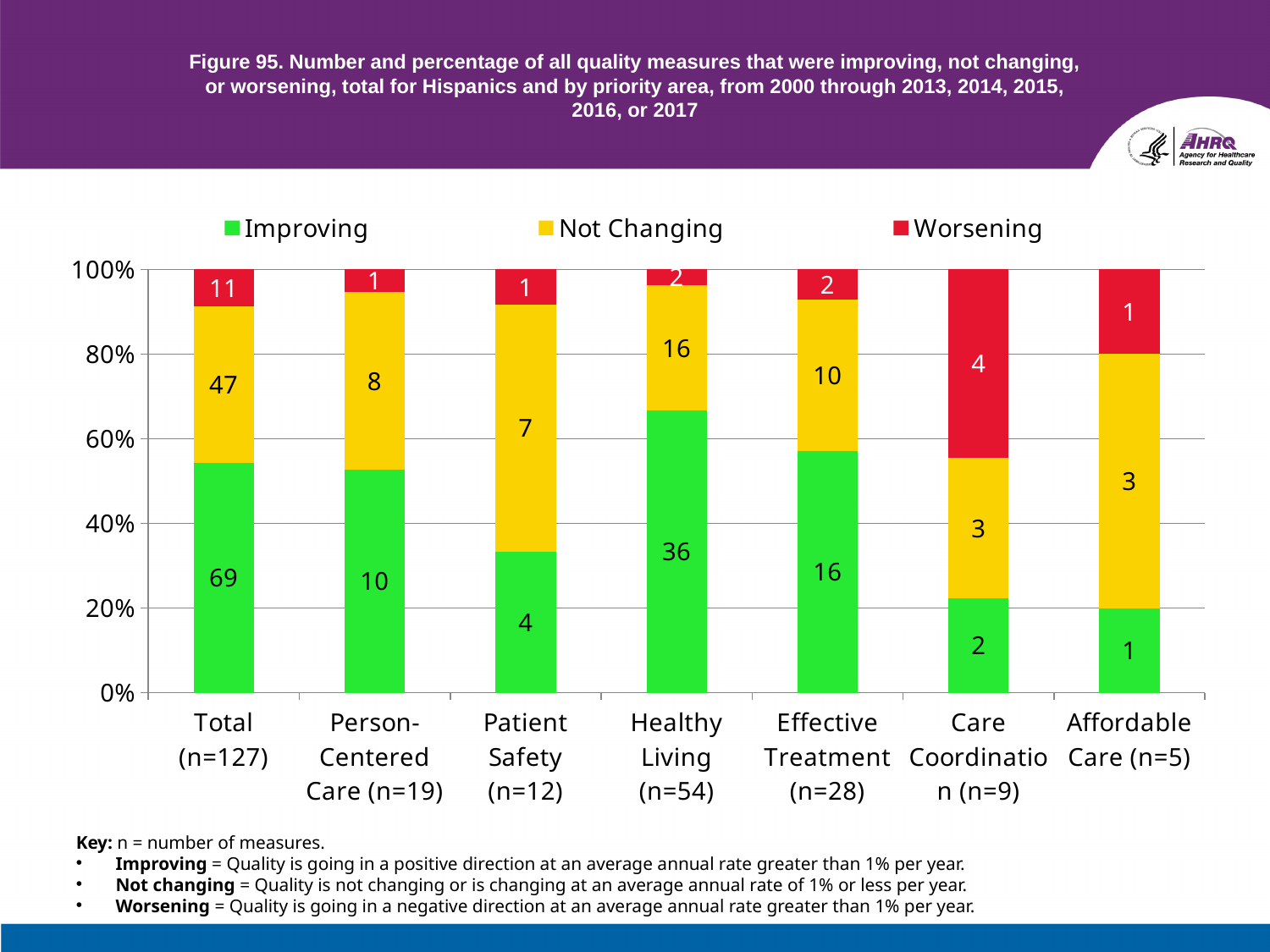
For Patient Safety (n=12), which is larger: the Improving value or the Not Changing value? Not Changing How many categories are shown on the x axis? 7 Is the Improving share of the Healthy Living (n=54) bar greater or less than 60%? greater How many Improving measures are shown for Healthy Living (n=54)? 36 What kind of chart is shown on the slide? Stacked bar chart What is the Not Changing value for Effective Treatment (n=28)? 10 How many series does the legend list? 3 What is the Worsening value for Care Coordination (n=9)? 4 Excluding Total, which category has the lowest Improving value? Affordable Care (n=5) What is the total of the three values in the Effective Treatment (n=28) bar? 28 Which category has the highest Improving value? Total (n=127) What is the difference between the Improving and Not Changing values for Total (n=127)? 22